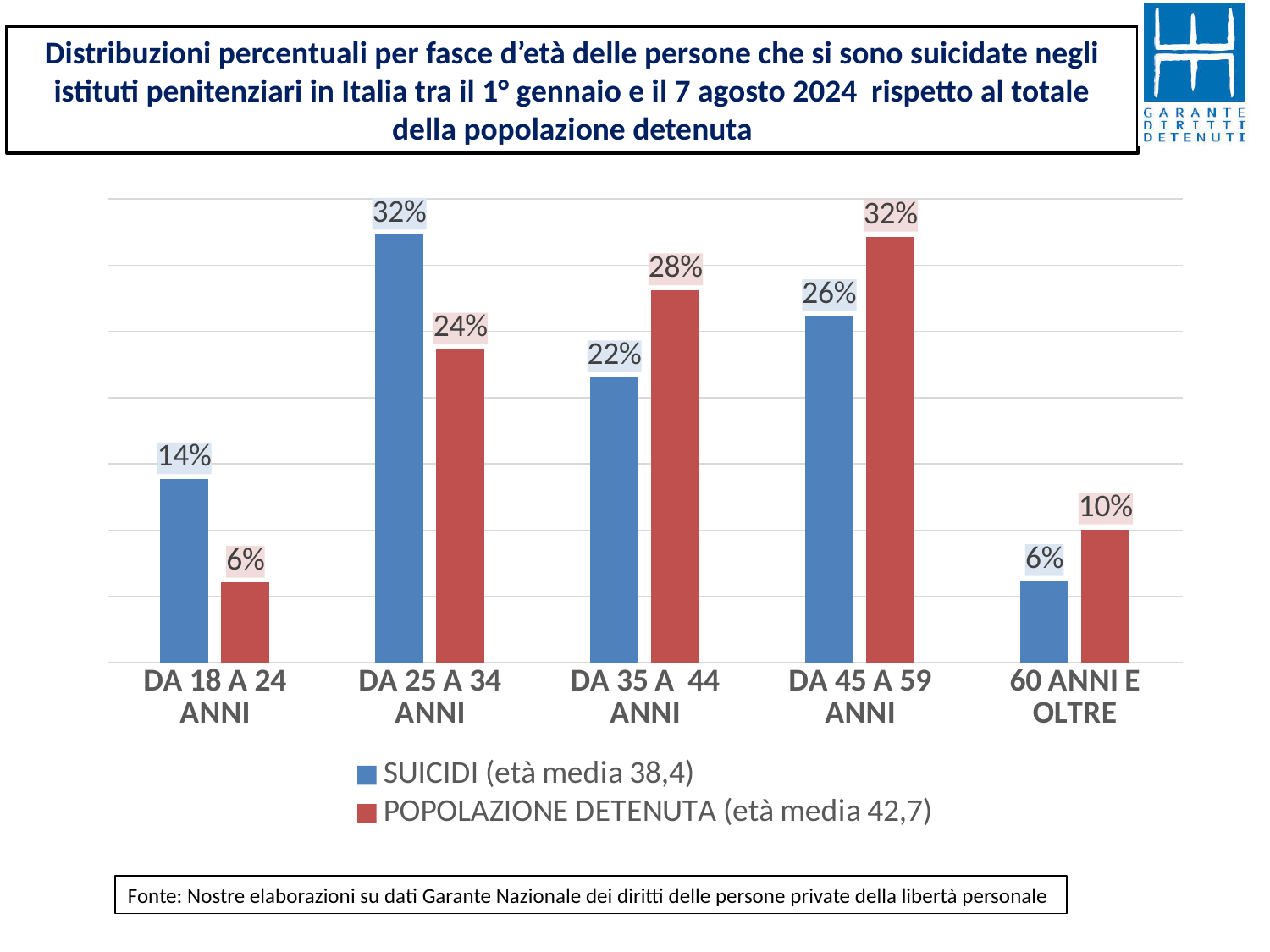
How many age groups are shown on the x axis? 5 What average age is given in the legend for the SUICIDI series? 38,4 Which age group has the highest POPOLAZIONE DETENUTA value? DA 45 A 59 ANNI For the DA 45 A 59 ANNI age group, which is larger: the SUICIDI value or the POPOLAZIONE DETENUTA value? POPOLAZIONE DETENUTA What is the difference between the SUICIDI and POPOLAZIONE DETENUTA values for the DA 18 A 24 ANNI age group? 8% Which age group has the lowest POPOLAZIONE DETENUTA value? DA 18 A 24 ANNI What kind of chart is shown on the slide? Bar chart How many series does the legend list? 2 What is the SUICIDI value for the DA 25 A 34 ANNI age group? 32% For the DA 25 A 34 ANNI age group, which is larger: the SUICIDI value or the POPOLAZIONE DETENUTA value? SUICIDI What is the SUICIDI value for the 60 ANNI E OLTRE age group? 6% What is the POPOLAZIONE DETENUTA value for the DA 35 A 44 ANNI age group? 28%